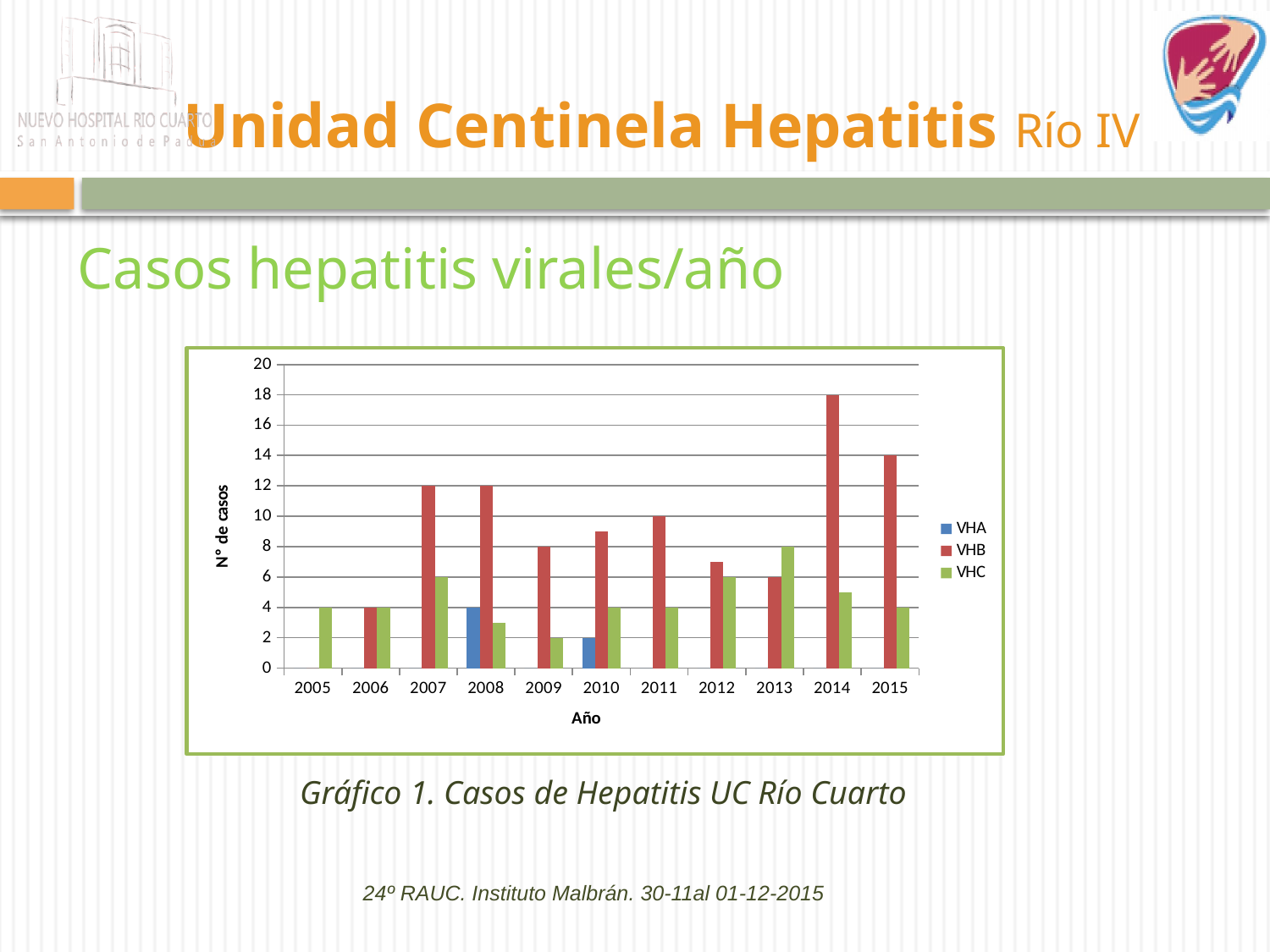
What is the VHA value for 2010? 2 What is the VHB value for 2014? 18 What is the label of the y axis? N° de casos What kind of chart is shown on the slide? bar chart How many series does the legend list? 3 Which is larger in 2013, VHB or VHC? VHC Which year has the highest VHB value? 2014 Is the VHB value for 2012 greater or less than 8? less What is the VHB value for 2015? 14 How many years are shown on the x axis? 11 What is the VHC value for 2013? 8 Is the VHB value for 2010 greater or less than 8? greater